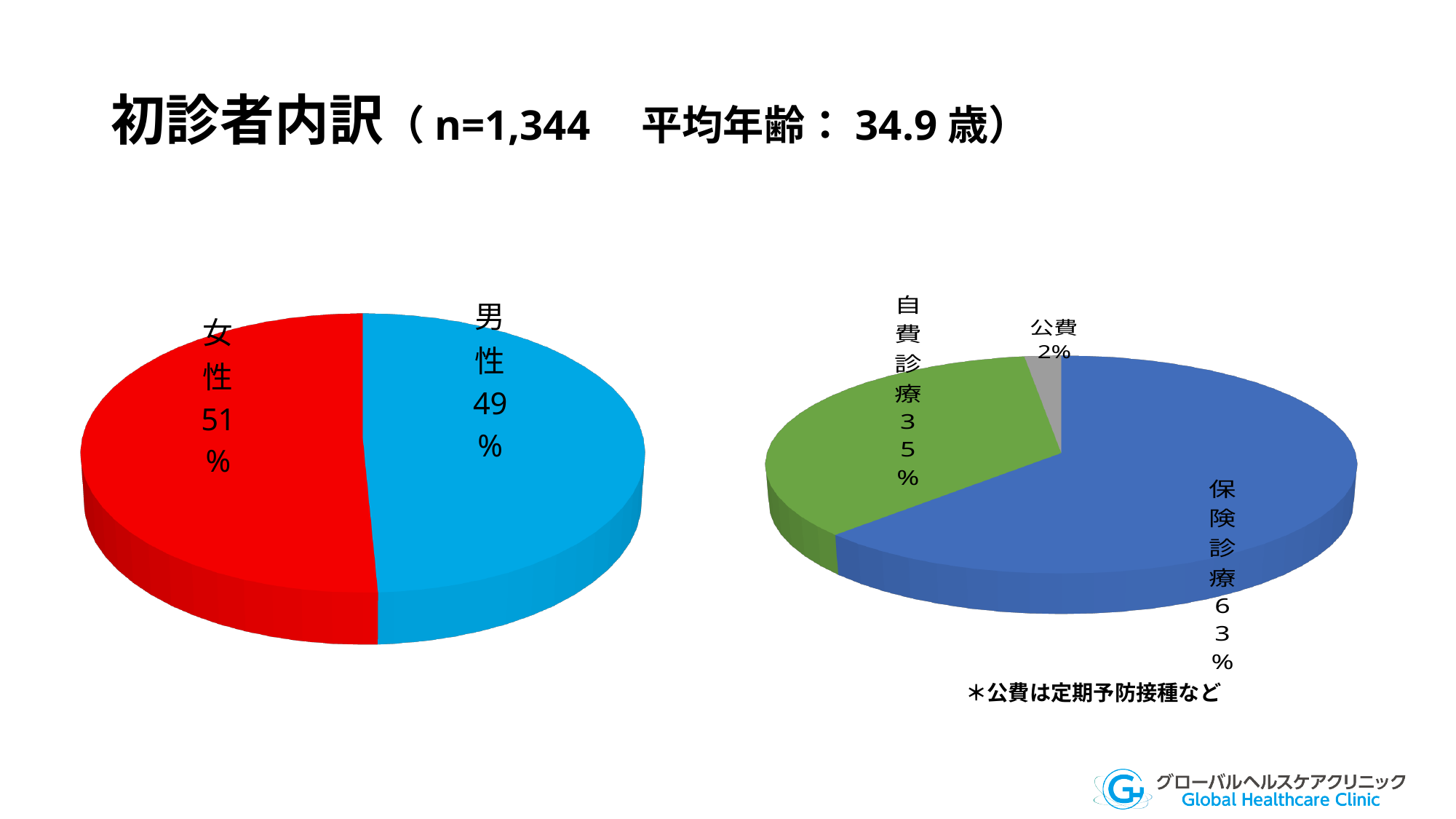
In the right pie chart, what is the difference between the 保険診療 and 自費診療 shares? 28% What type of chart is used for both charts on the slide? Pie chart In the left pie chart, what share is labelled for 男性? 49% In the right pie chart, what share is labelled for 公費? 2% How many slices does the left pie chart have? 2 In the left pie chart, what is the difference between the 女性 and 男性 shares? 2% In the right pie chart, which category has the largest share? 保険診療 In the right pie chart, what share is labelled for 保険診療? 63% In the right pie chart, what share is labelled for 自費診療? 35% In the left pie chart, what share is labelled for 女性? 51% In the right pie chart, which category has the smallest share? 公費 In the left pie chart, which slice is larger, 女性 or 男性? 女性